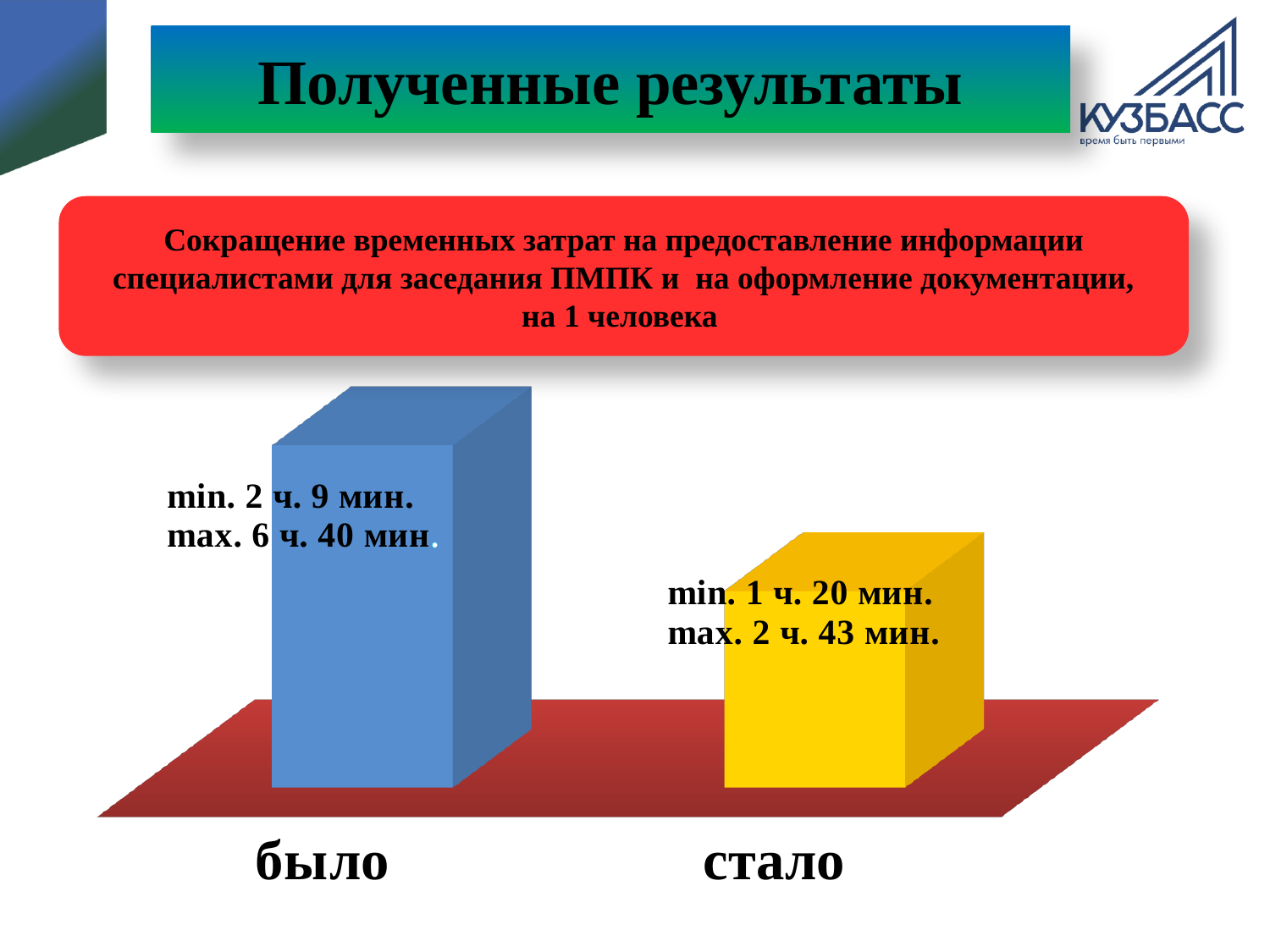
What is the minimum time shown for "было"? 2 ч. 9 мин. Which category has the highest bar? было Which category has the lowest bar? стало What colour is the "было" bar? blue What is the maximum time shown for "было"? 6 ч. 40 мин. Which bar is taller, "было" or "стало"? было How many bars does the chart have? 2 What is the maximum time shown for "стало"? 2 ч. 43 мин. What kind of chart is shown on the slide? bar chart What colour is the "стало" bar? yellow By how much is the maximum time for "было" greater than the maximum time for "стало"? 3 ч. 57 мин. What is the minimum time shown for "стало"? 1 ч. 20 мин.